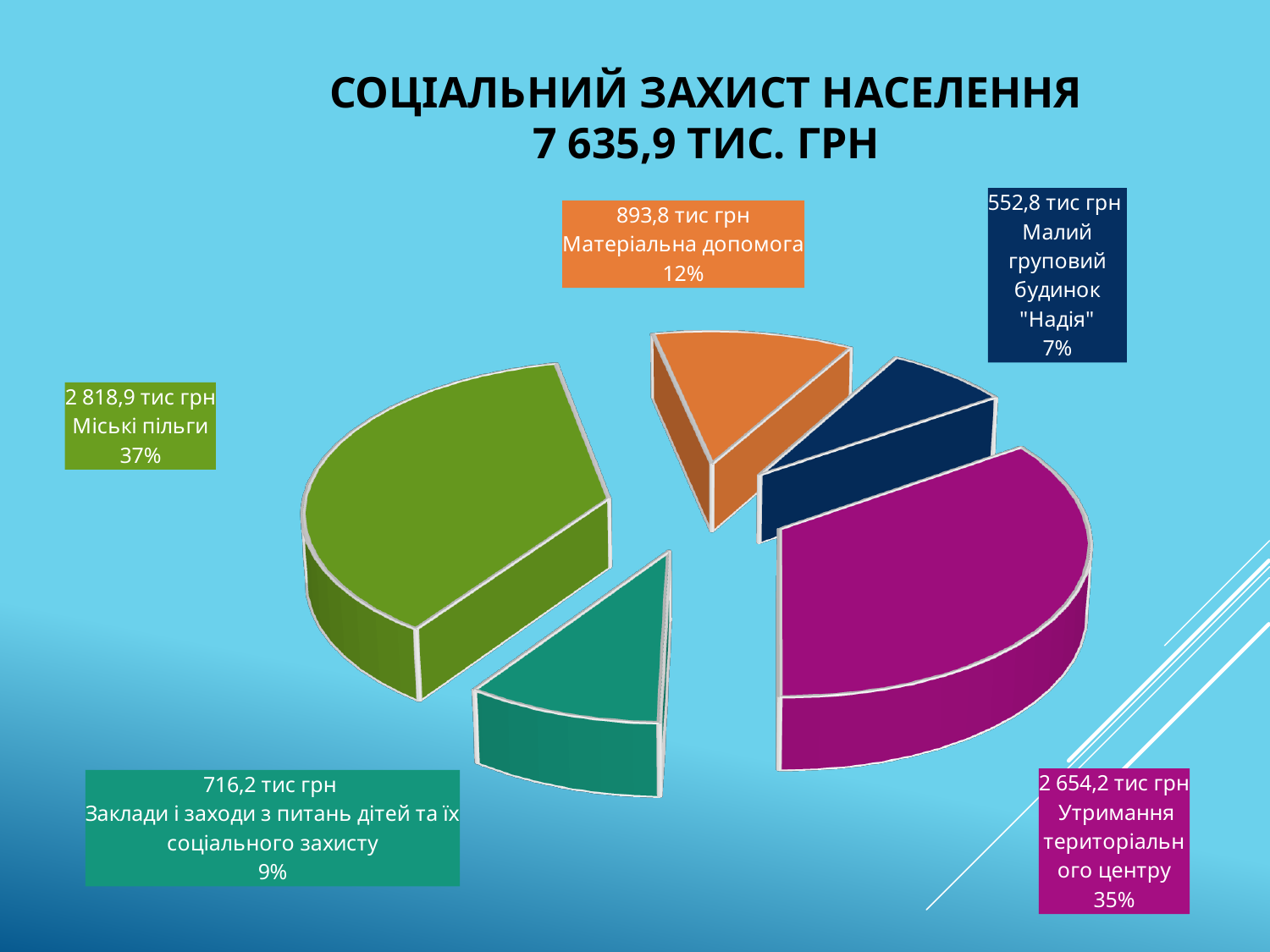
What is the value for Міські пільги? 2 818,9 тис грн What is the value for Матеріальна допомога? 893,8 тис грн What share of the pie does Заклади і заходи з питань дітей та їх соціального захисту represent? 9% What total amount is stated in the chart title? 7 635,9 тис. грн What is the difference between the values for Міські пільги and Утримання територіального центру? 164,7 тис грн Which is larger, the value for Матеріальна допомога or the value for Заклади і заходи з питань дітей та їх соціального захисту? Матеріальна допомога What is the value for Утримання територіального центру? 2 654,2 тис грн How many slices does the pie chart have? 5 What share of the pie does Малий груповий будинок "Надія" represent? 7% Which category has the largest slice? Міські пільги What type of chart is shown on the slide? Pie chart Which category has the smallest slice? Малий груповий будинок "Надія"